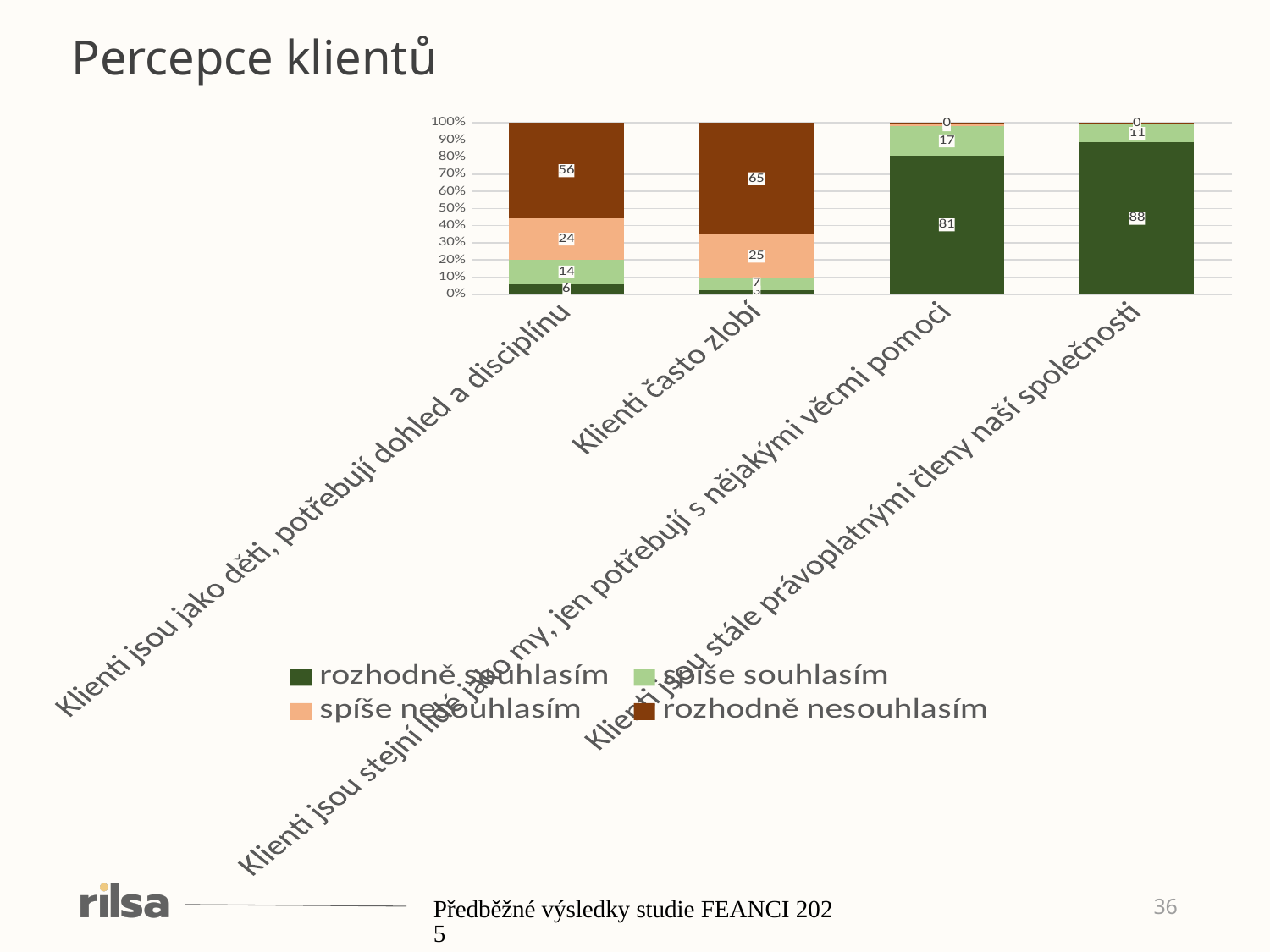
What is the value of "spíše nesouhlasím" for "Klienti jsou jako děti, potřebují dohled a disciplínu"? 24 How many categories (statements) are plotted on the x axis? 4 What is the value of "rozhodně souhlasím" for "Klienti jsou stále právoplatnými členy naší společnosti"? 88 What kind of chart is shown on the slide? Stacked bar chart Which statement has the highest value for "rozhodně souhlasím"? Klienti jsou stále právoplatnými členy naší společnosti How many series does the legend list? 4 What is the value of "spíše souhlasím" for "Klienti jsou stejní lidé jako my, jen potřebují s nějakými věcmi pomoci"? 17 What is the value of "rozhodně nesouhlasím" for "Klienti často zlobí"? 65 What is the difference between the "rozhodně nesouhlasím" values for "Klienti často zlobí" and "Klienti jsou jako děti, potřebují dohled a disciplínu"? 9 Which has the larger "spíše souhlasím" value: "Klienti jsou jako děti, potřebují dohled a disciplínu" or "Klienti často zlobí"? Klienti jsou jako děti, potřebují dohled a disciplínu What colour represents "rozhodně nesouhlasím" in the legend? Dark brown What is the value of "rozhodně souhlasím" for "Klienti jsou stejní lidé jako my, jen potřebují s nějakými věcmi pomoci"? 81